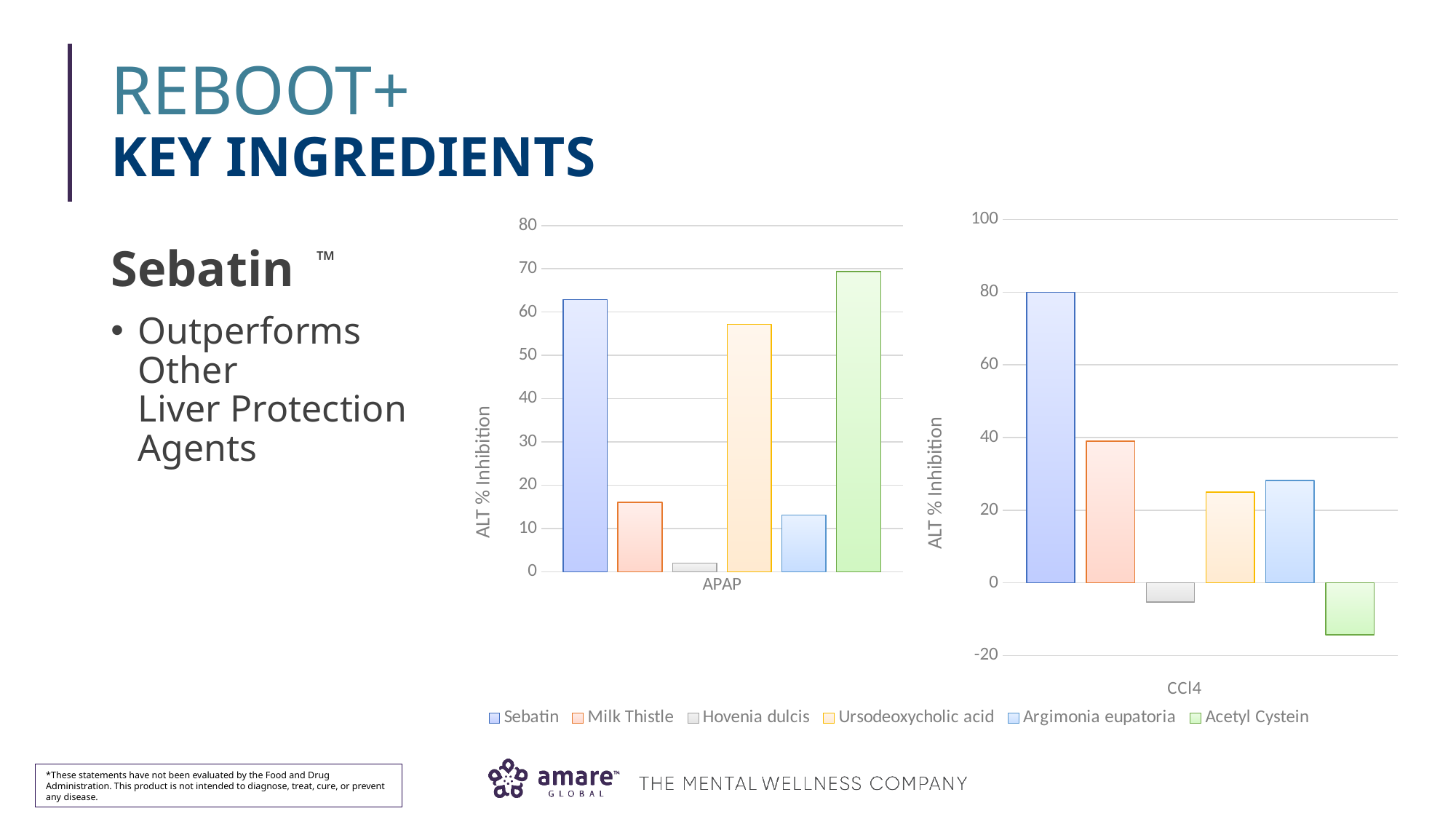
In the CCl4 chart, which series has the highest ALT % Inhibition? Sebatin In the APAP chart, which series has the highest ALT % Inhibition? Acetyl Cystein How many series does the legend list? 6 In the APAP chart, is the value for Sebatin greater or less than 60? greater In the CCl4 chart, is the value for Milk Thistle greater or less than 60? less In the APAP chart, is the value for Milk Thistle greater or less than 20? less What is the y-axis label on the CCl4 chart? ALT % Inhibition In the APAP chart, which is larger, the value for Ursodeoxycholic acid or the value for Argimonia eupatoria? Ursodeoxycholic acid What kind of chart is the APAP chart on the left? bar chart In the APAP chart, which series has the lowest ALT % Inhibition? Hovenia dulcis In the CCl4 chart, which series has the lowest ALT % Inhibition? Acetyl Cystein In the CCl4 chart, which is larger, the value for Sebatin or the value for Milk Thistle? Sebatin